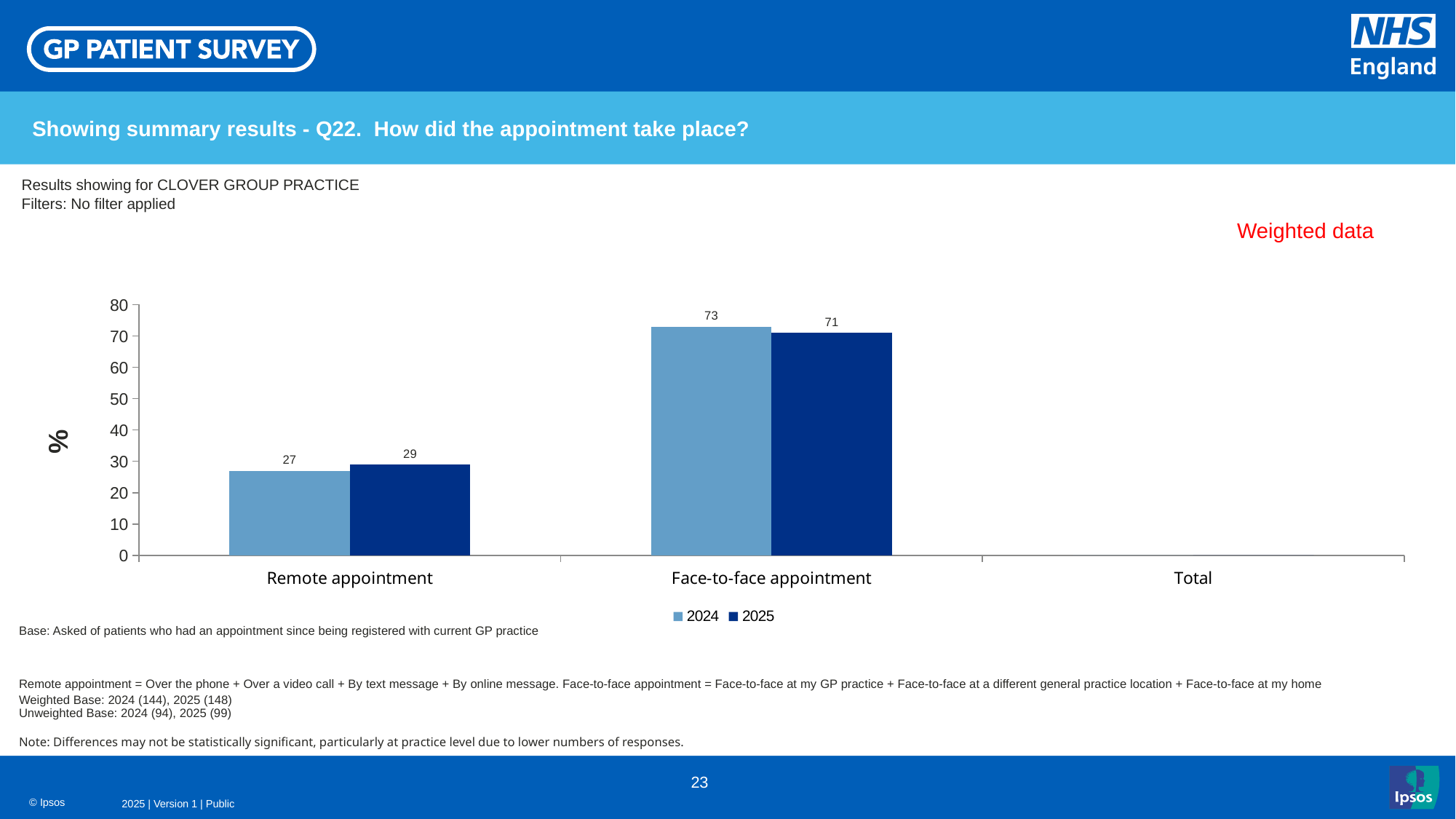
What kind of chart is shown on the slide? Bar chart How many series does the legend list? 2 What label is shown on the vertical axis? % Which category has the lowest 2025 value? Remote appointment What is the 2025 value for Face-to-face appointment? 71 What is the difference between the 2024 and 2025 values for Face-to-face appointment? 2 What is the 2025 value for Remote appointment? 29 Which is larger for Remote appointment, the 2024 value or the 2025 value? 2025 Is the 2025 value for Face-to-face appointment greater or less than 60? greater What is the 2024 value for Face-to-face appointment? 73 Which category has the highest 2024 value? Face-to-face appointment What is the 2024 value for Remote appointment? 27